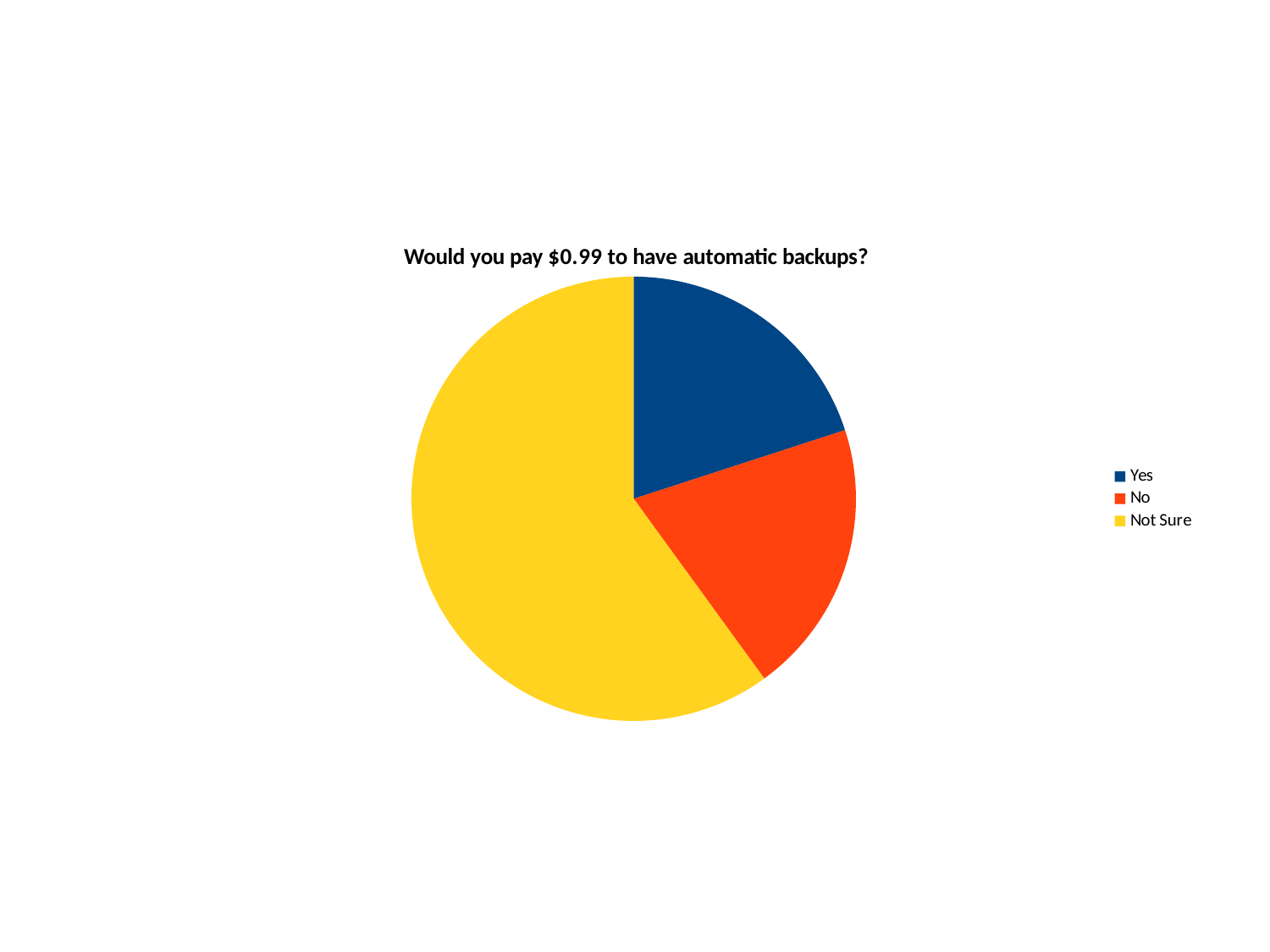
What kind of chart is shown on the slide? pie chart Which slice is larger, Not Sure or No? Not Sure Which response is shown in yellow in the legend? Not Sure How many entries does the legend list? 3 Which slice is larger, Not Sure or Yes? Not Sure What is the title of the chart? Would you pay $0.99 to have automatic backups? How many slices does the pie chart have? 3 Which response has the largest slice of the pie? Not Sure